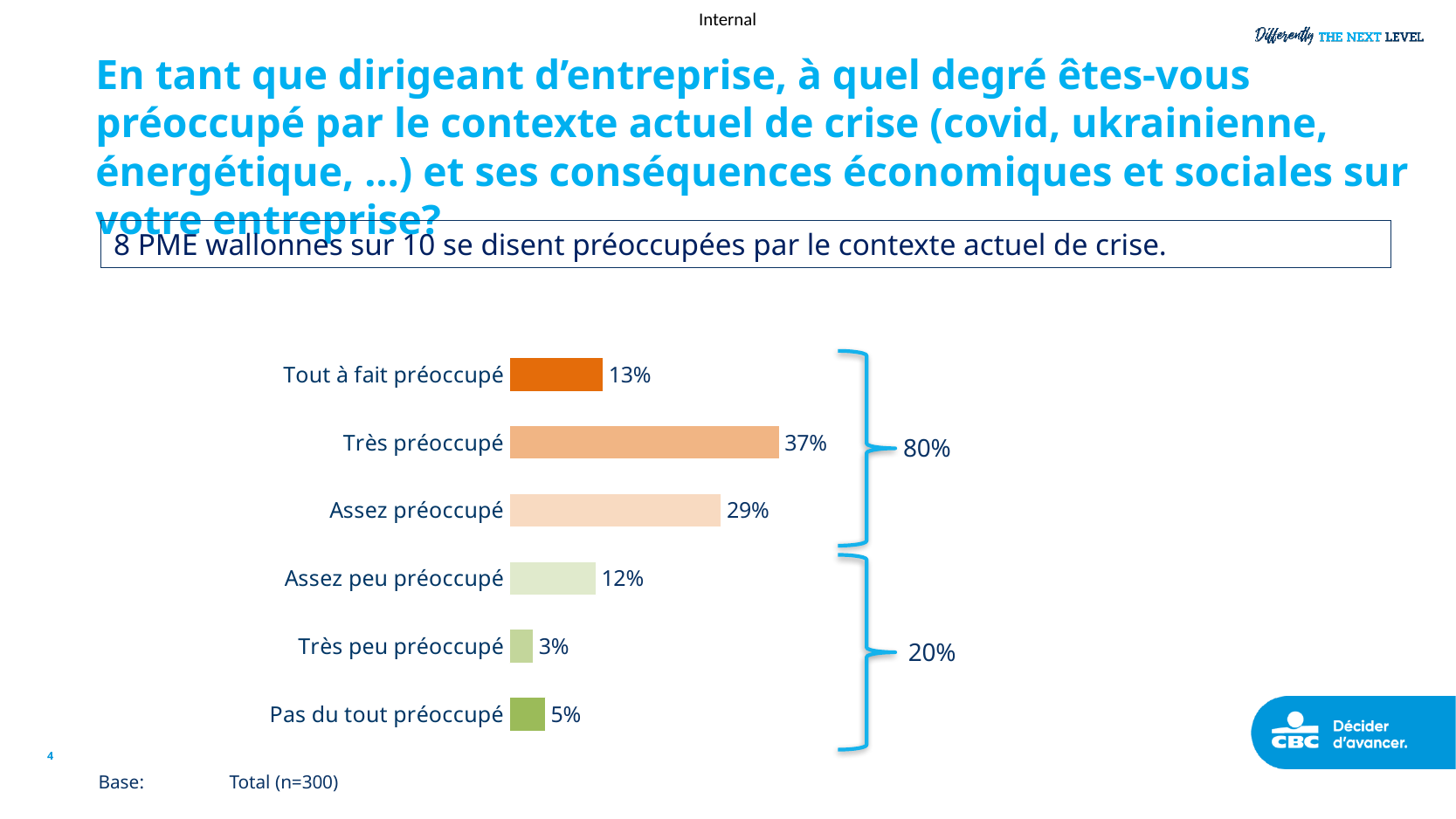
Which category has the highest value? Très préoccupé What kind of chart is shown on the slide? Bar chart What is the value for "Tout à fait préoccupé"? 13% How many categories are shown in the chart? 6 What is the value for "Pas du tout préoccupé"? 5% Which category has the lowest value? Très peu préoccupé What is the value for "Très peu préoccupé"? 3% What combined percentage is shown by the bracket grouping the three "préoccupé" categories? 80% What is the value for "Très préoccupé"? 37% What is the difference between "Très préoccupé" and "Assez préoccupé"? 8% What is the sample size given in the base note below the chart? n=300 Which is larger, "Assez peu préoccupé" or "Tout à fait préoccupé"? Tout à fait préoccupé